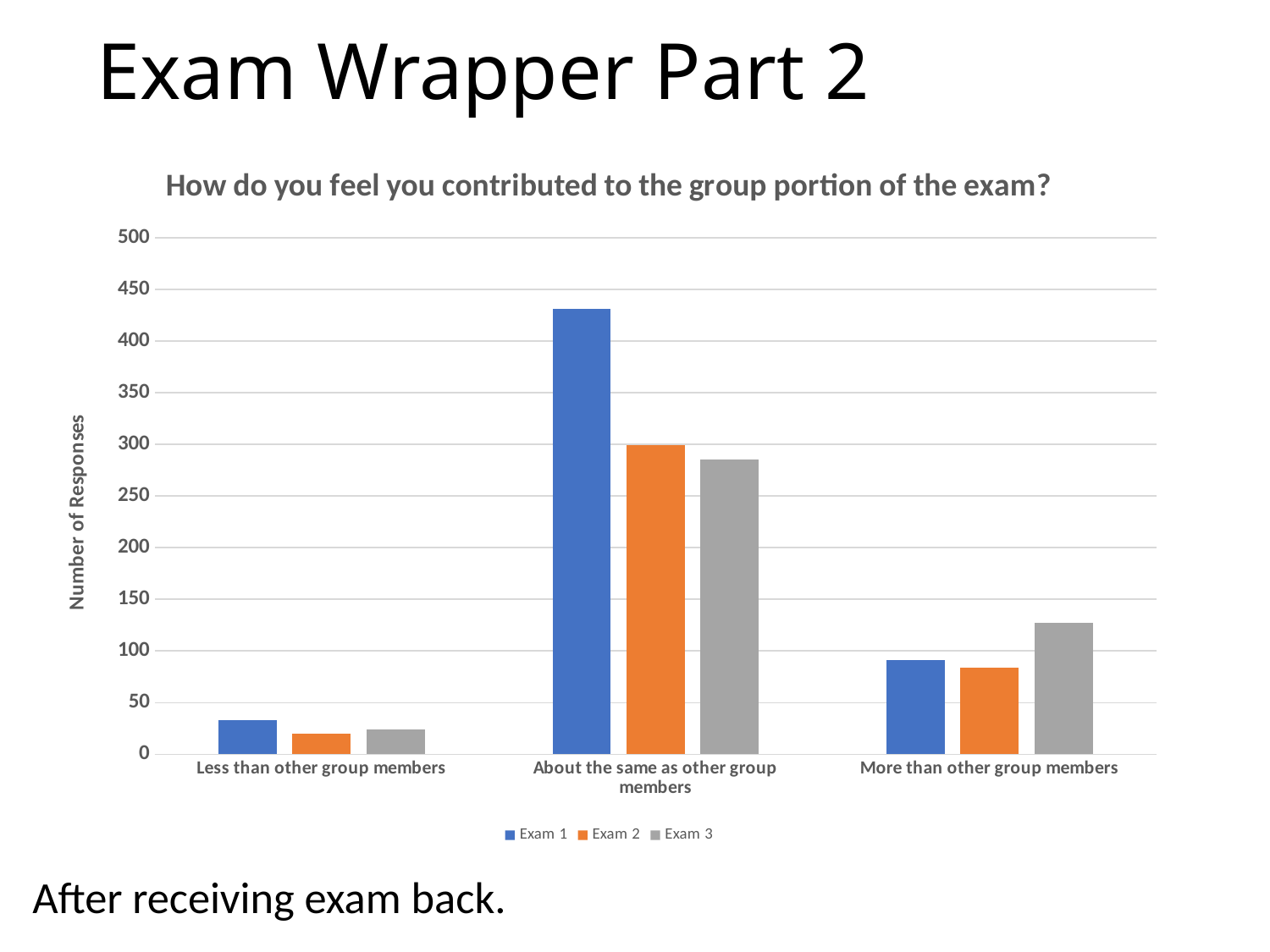
What kind of chart is shown on the slide? bar chart What is the label of the vertical axis? Number of Responses Which category has the lowest value for Exam 3? Less than other group members How many series does the legend list? 3 How many categories are shown on the x axis? 3 What is the title of the chart? How do you feel you contributed to the group portion of the exam? In 'About the same as other group members', which is larger: Exam 1 or Exam 2? Exam 1 Is the value for Exam 1 in 'Less than other group members' greater or less than 50? less In 'More than other group members', which is larger: Exam 1 or Exam 3? Exam 3 Is the value for Exam 1 in 'About the same as other group members' greater or less than 400? greater Is the value for Exam 3 in 'More than other group members' greater or less than 100? greater Which category has the highest value for Exam 1? About the same as other group members